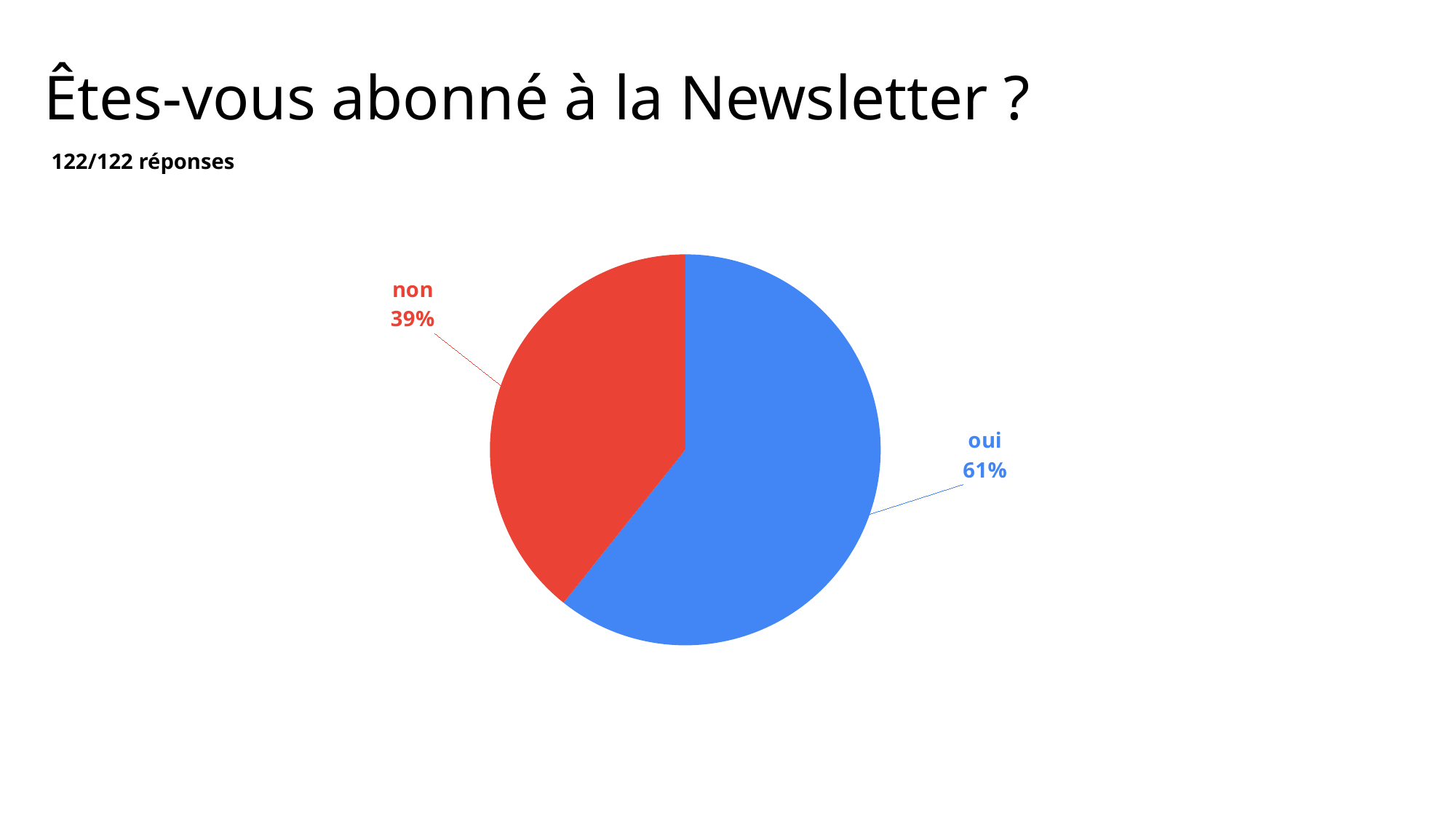
Which slice is the largest in the pie chart? oui How many slices does the pie chart have? 2 What colour is the "oui" slice? blue What share of the pie does the "non" slice represent? 39% Is the share for "non" greater or less than 50%? less What share of the pie does the "oui" slice represent? 61% Which slice is the smallest in the pie chart? non What kind of chart is shown on the slide? pie chart How many responses does the slide say the chart is based on? 122/122 réponses What is the difference in percentage points between the "oui" and "non" slices? 22 percentage points Which is larger, the "oui" slice or the "non" slice? oui